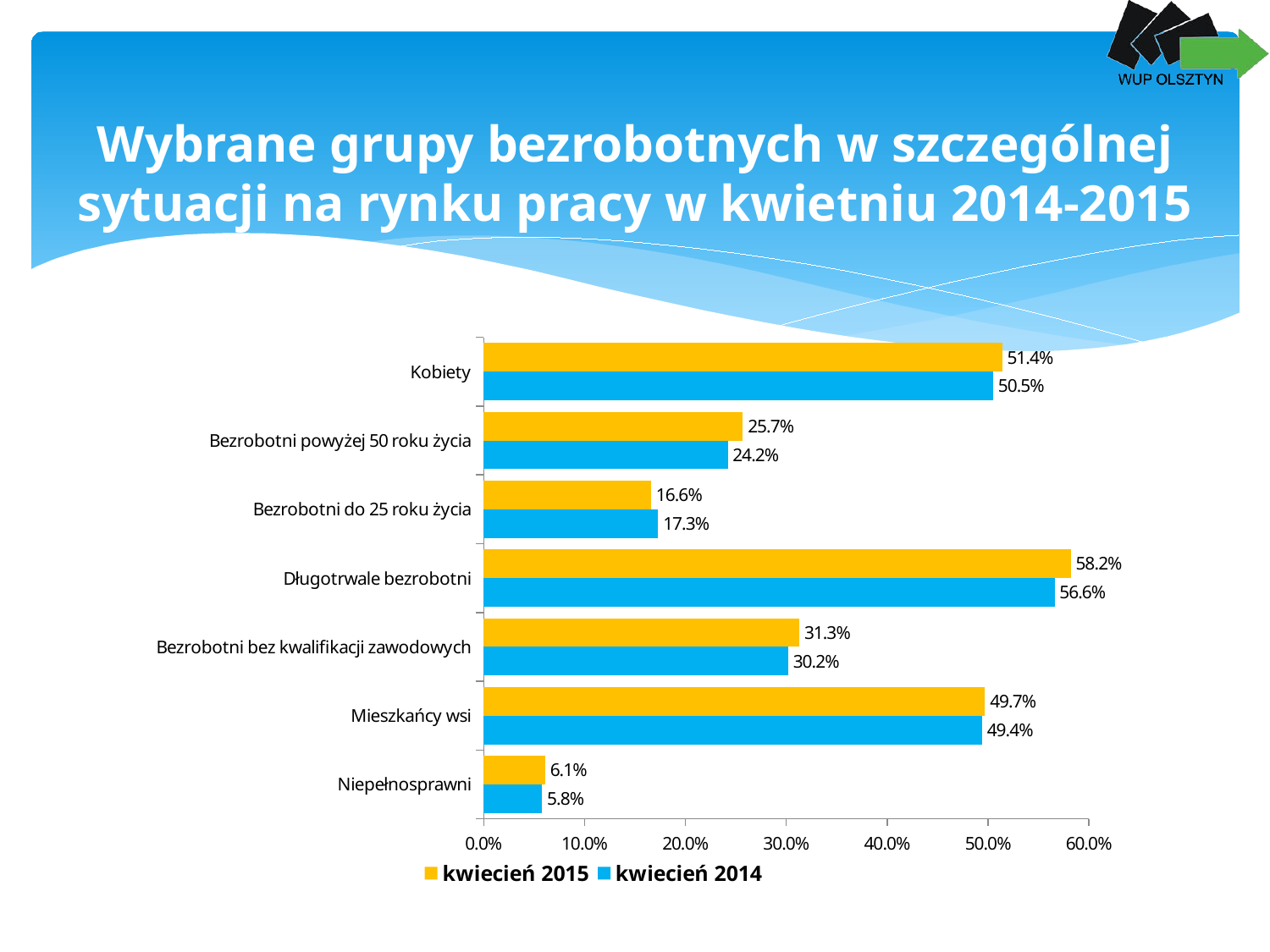
Which category has the lowest value in kwiecień 2014? Niepełnosprawni What kind of chart is shown on the slide? bar chart How many categories are shown on the chart? 7 Which category has the highest value in kwiecień 2015? Długotrwale bezrobotni Which colour represents kwiecień 2014 in the chart? blue What is the difference between the kwiecień 2015 and kwiecień 2014 values for Bezrobotni powyżej 50 roku życia? 1.5% How many series does the legend list? 2 Is the value for Mieszkańcy wsi in kwiecień 2015 greater or less than 40.0%? greater Which is larger for Bezrobotni do 25 roku życia: the kwiecień 2015 value or the kwiecień 2014 value? kwiecień 2014 What is the value for Długotrwale bezrobotni in kwiecień 2014? 56.6% What is the value for Niepełnosprawni in kwiecień 2015? 6.1% What is the value for Kobiety in kwiecień 2015? 51.4%